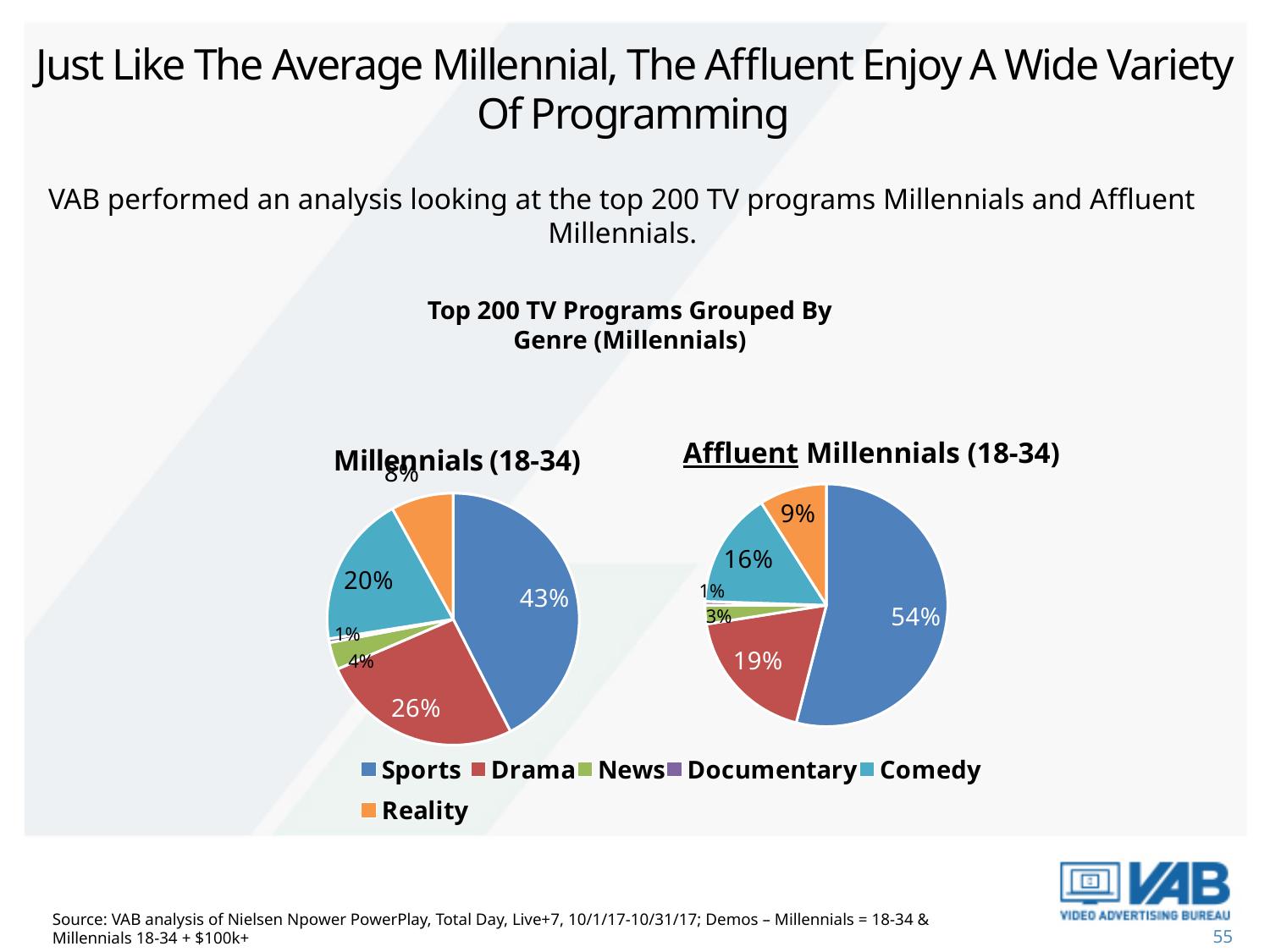
In the Affluent Millennials (18-34) pie chart, what share is Sports? 54% In the Millennials (18-34) pie chart, which genre has the largest share? Sports What is the difference between the Sports share in the Affluent Millennials (18-34) chart and the Sports share in the Millennials (18-34) chart? 11% In the Affluent Millennials (18-34) pie chart, what share is Reality? 9% Is the Drama share larger in the Millennials (18-34) chart or the Affluent Millennials (18-34) chart? Millennials (18-34) What kind of charts are shown on the slide? Pie charts How many genres does the legend list? 6 In the Affluent Millennials (18-34) pie chart, which genre has the smallest share? Documentary What colour represents Comedy in the pie charts? Teal In the Millennials (18-34) pie chart, what share is Drama? 26% In the Millennials (18-34) pie chart, what share is Sports? 43% In the Affluent Millennials (18-34) pie chart, what share is Comedy? 16%